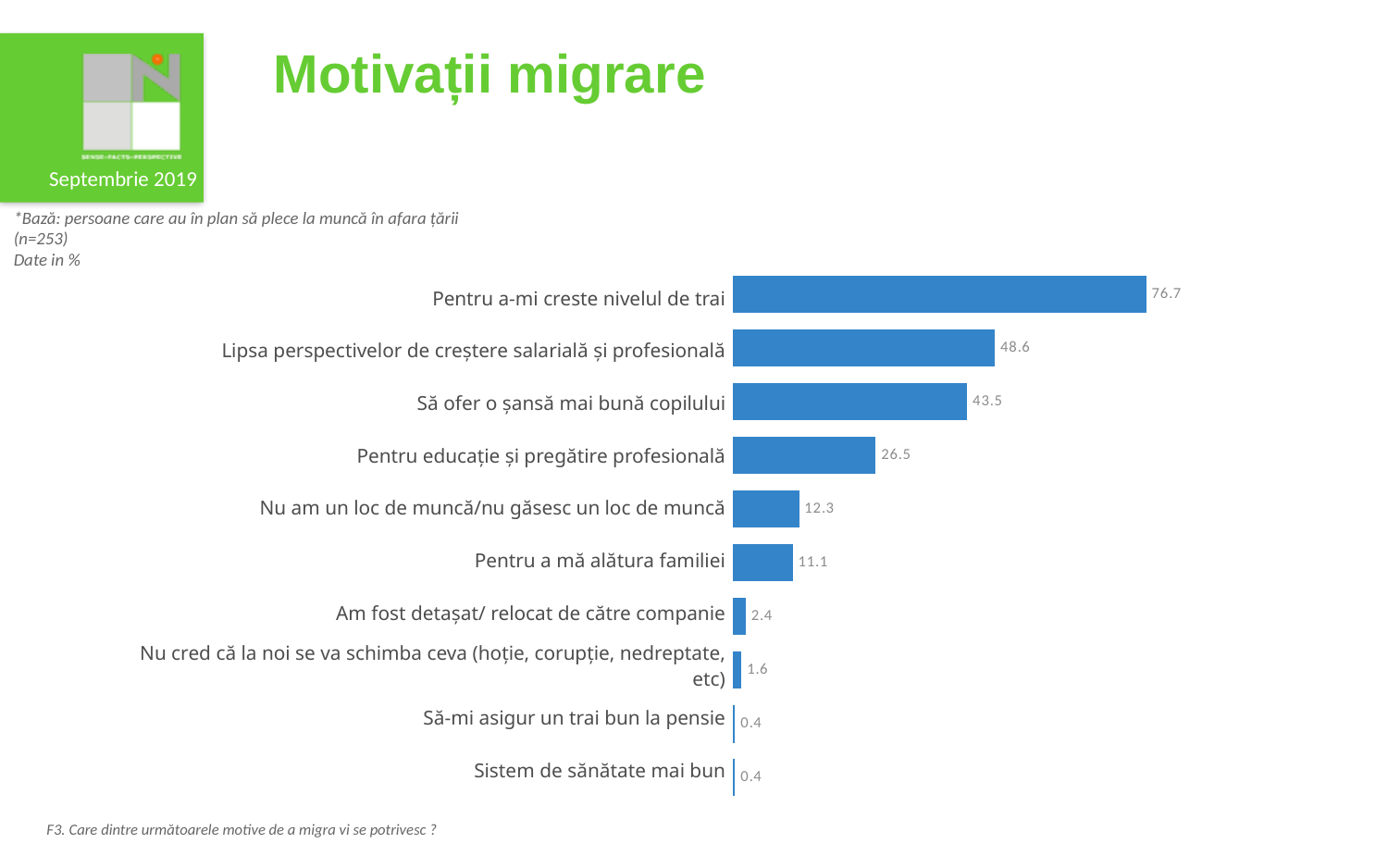
What is the sample size (n) stated on the slide? 253 What is the value for "Nu am un loc de muncă/nu găsesc un loc de muncă"? 12.3 What kind of chart is shown on the slide? Bar chart What is the difference between "Pentru a-mi creste nivelul de trai" and "Pentru educație și pregătire profesională"? 50.2 What is the title of the slide containing the chart? Motivații migrare What is the difference between "Lipsa perspectivelor de creștere salarială și profesională" and "Să ofer o șansă mai bună copilului"? 5.1 What is the value for "Să ofer o șansă mai bună copilului"? 43.5 Which category has the highest value? Pentru a-mi creste nivelul de trai Which is larger: "Pentru educație și pregătire profesională" or "Pentru a mă alătura familiei"? Pentru educație și pregătire profesională What is the value for "Am fost detașat/ relocat de către companie"? 2.4 What is the value for "Pentru a-mi creste nivelul de trai"? 76.7 How many categories are shown in the chart? 10